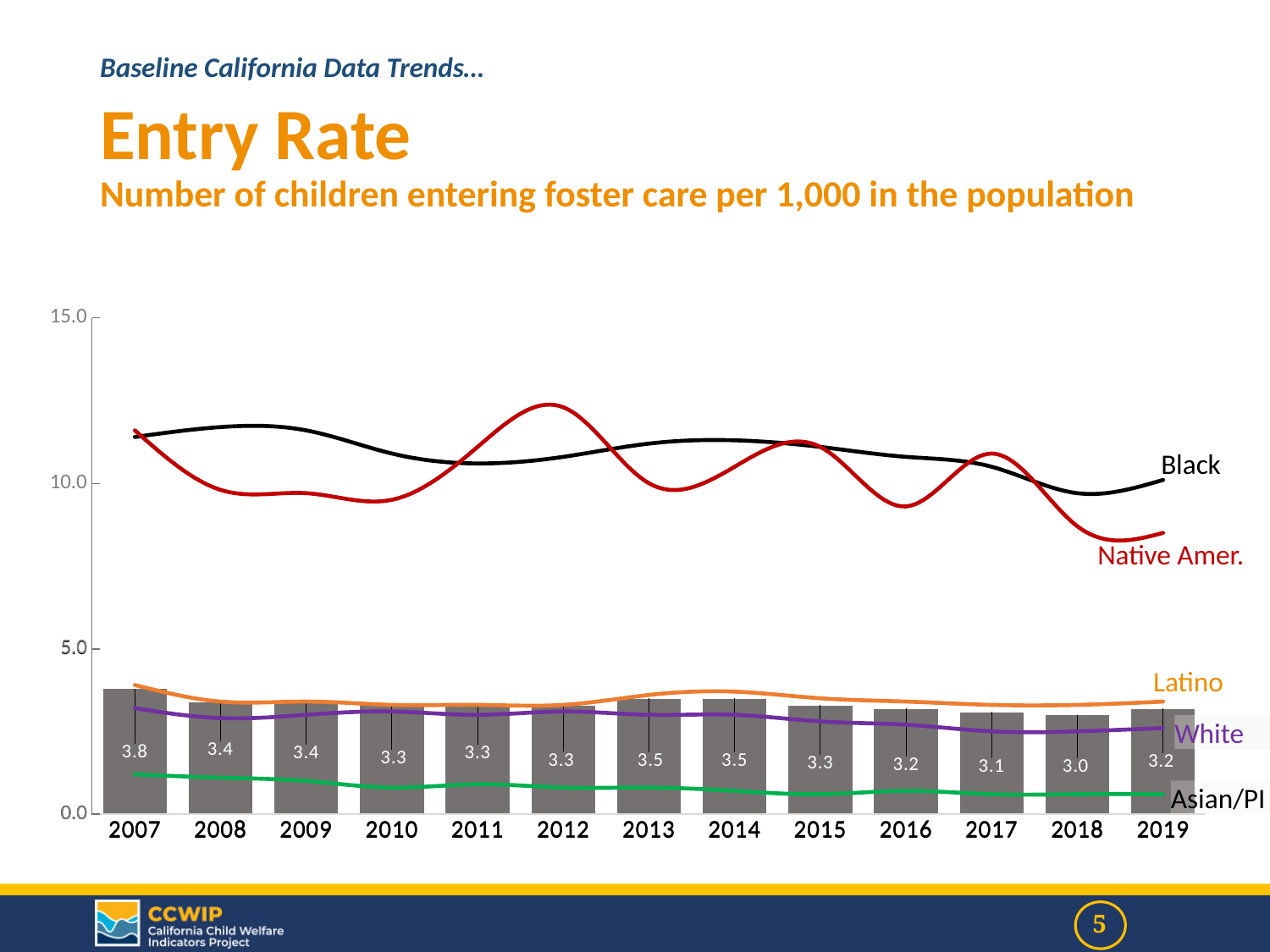
Which bar value is larger, 2014 or 2016? 2014 What is the difference between the bar values for 2007 and 2018? 0.8 Do the bar values generally rise or fall from 2007 to 2018? fall What is the value of the bar for 2018? 3.0 What is the value of the bar for 2013? 3.5 What is the value of the bar for 2007? 3.8 How many years are shown on the x axis? 13 Which year has the highest bar value? 2007 How many labeled lines are plotted on the chart? 5 Is the value of the Black line in 2007 greater or less than 10.0? greater Which year has the lowest bar value? 2018 Is the value of the Native Amer. line in 2019 greater or less than 10.0? less